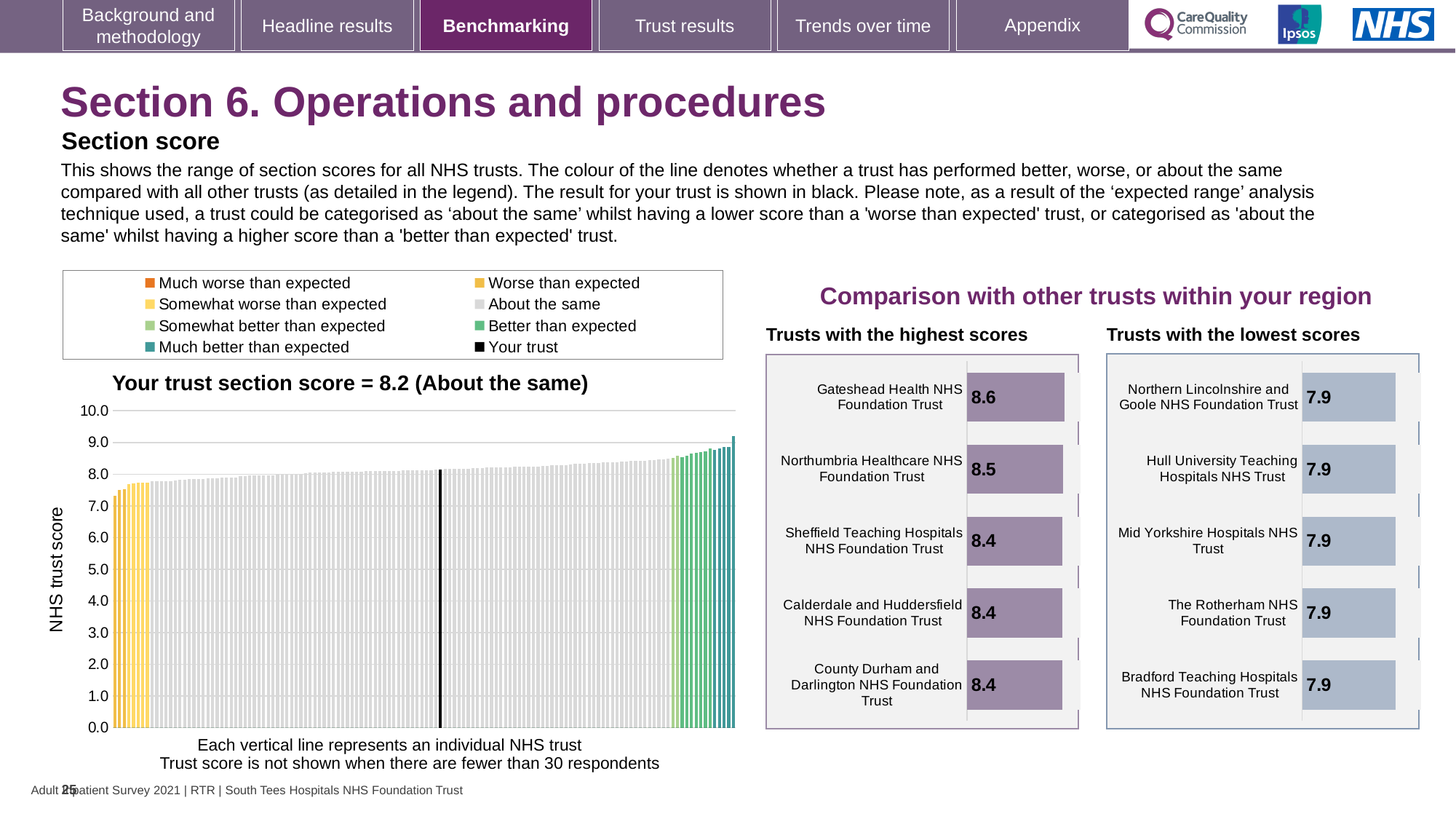
In the 'Trusts with the highest scores' chart, what is the score for Gateshead Health NHS Foundation Trust? 8.6 In the 'Trusts with the highest scores' chart, what is the difference between the scores of Gateshead Health NHS Foundation Trust and Sheffield Teaching Hospitals NHS Foundation Trust? 0.2 How many trusts are listed in the 'Trusts with the lowest scores' chart? 5 In the large chart on the left showing all NHS trusts, do the values rise or fall from left to right? Rise In the large chart on the left showing all NHS trusts, what is the section score for your trust? 8.2 In the 'Trusts with the lowest scores' chart, what is the score for Bradford Teaching Hospitals NHS Foundation Trust? 7.9 In the 'Trusts with the lowest scores' chart, what is the score for Hull University Teaching Hospitals NHS Trust? 7.9 In the 'Trusts with the highest scores' chart, which trust has the highest score? Gateshead Health NHS Foundation Trust In the 'Trusts with the highest scores' chart, what is the score for Northumbria Healthcare NHS Foundation Trust? 8.5 What kind of chart is the large chart on the left showing all NHS trusts? Bar chart In the 'Trusts with the highest scores' chart, which is larger: the score for Northumbria Healthcare NHS Foundation Trust or the score for County Durham and Darlington NHS Foundation Trust? Northumbria Healthcare NHS Foundation Trust How many trusts are listed in the 'Trusts with the highest scores' chart? 5